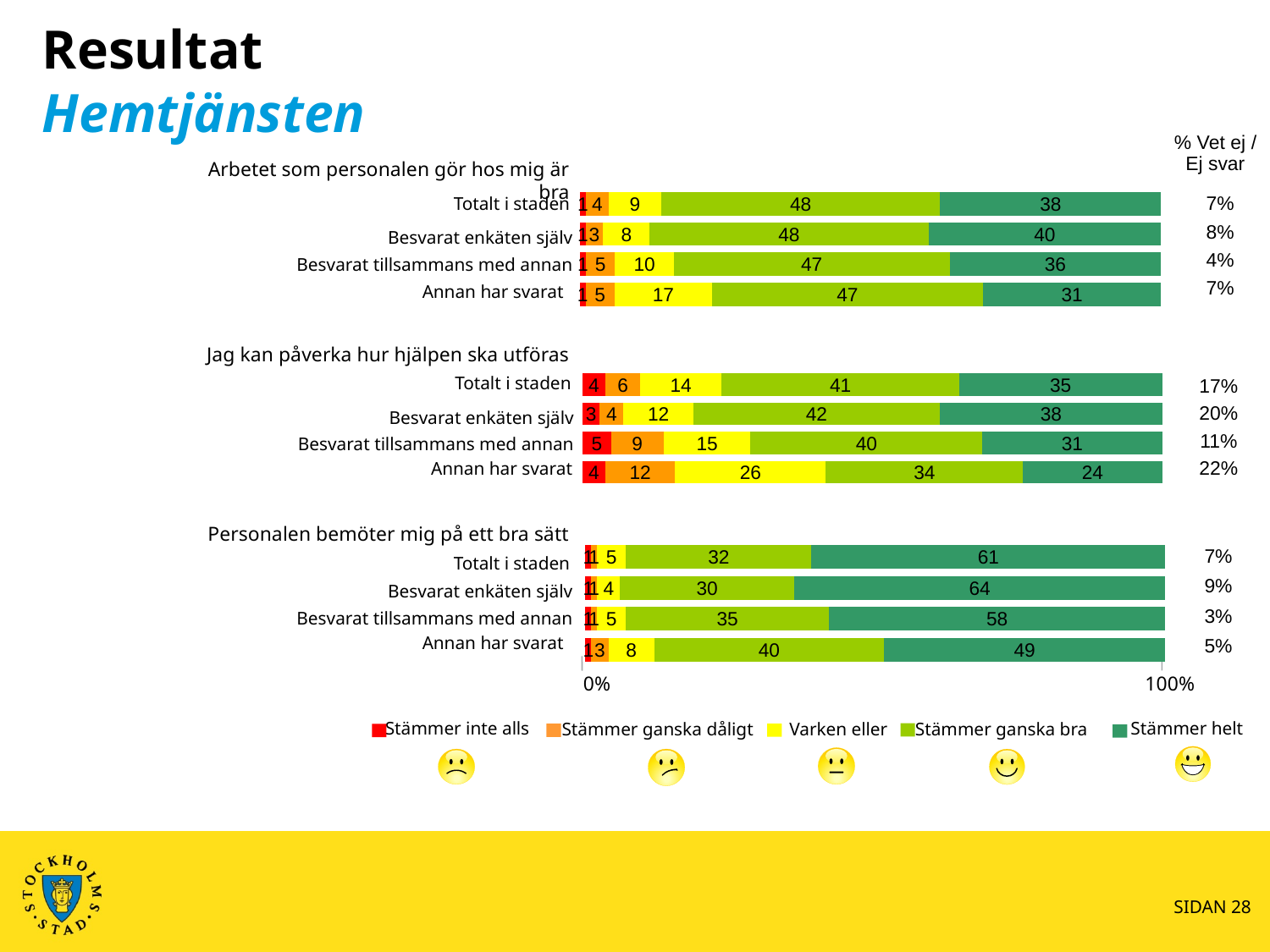
In the group "Jag kan påverka hur hjälpen ska utföras", which row has the lowest "Stämmer helt" value? Annan har svarat How many bars are plotted in total across the three groups? 12 How many series does the legend list? 5 In the group "Personalen bemöter mig på ett bra sätt", what is the difference between the "Stämmer helt" values for "Besvarat enkäten själv" and "Annan har svarat"? 15 For "Totalt i staden", is the "Stämmer ganska bra" value larger in the group "Arbetet som personalen gör hos mig är bra" or in the group "Jag kan påverka hur hjälpen ska utföras"? Arbetet som personalen gör hos mig är bra In the group "Arbetet som personalen gör hos mig är bra", what is the "Varken eller" value for "Annan har svarat"? 17 What kind of chart is shown on the slide? Stacked bar chart In the group "Jag kan påverka hur hjälpen ska utföras", what is the "Stämmer ganska bra" value for "Annan har svarat"? 34 In the group "Personalen bemöter mig på ett bra sätt", what is the "Stämmer helt" value for "Totalt i staden"? 61 What is the "% Vet ej / Ej svar" value for "Annan har svarat" in the group "Jag kan påverka hur hjälpen ska utföras"? 22% In the group "Personalen bemöter mig på ett bra sätt", which row has the highest "Stämmer helt" value? Besvarat enkäten själv Which legend entry is shown in dark green? Stämmer helt